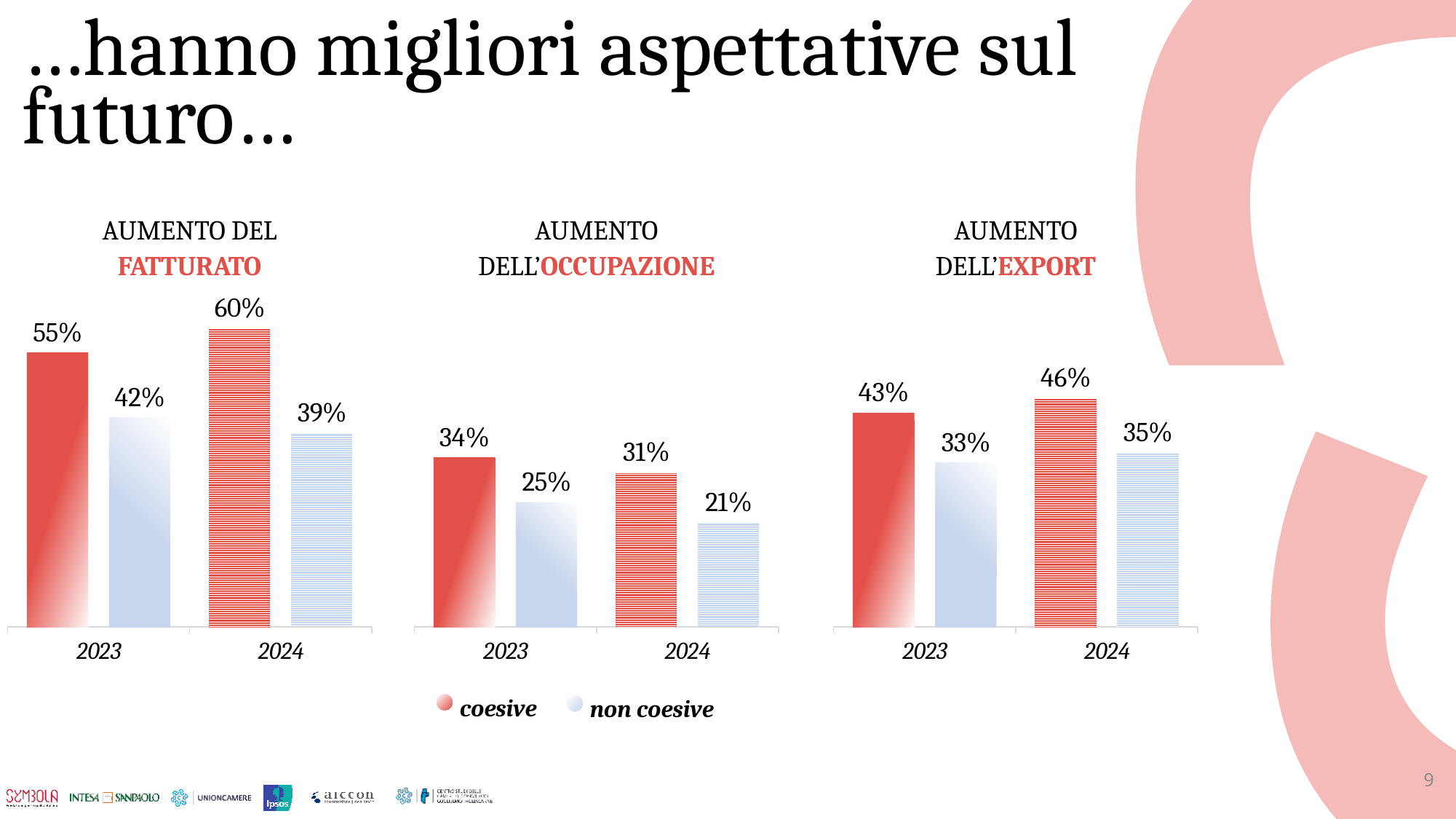
In the 'AUMENTO DELL'EXPORT' chart, what is the value for coesive in 2023? 43% In the 'AUMENTO DEL FATTURATO' chart, what is the difference between coesive and non coesive in 2024? 21% In the 'AUMENTO DEL FATTURATO' chart, what is the value for coesive in 2024? 60% In the 'AUMENTO DELL'OCCUPAZIONE' chart, which is larger: coesive in 2024 or non coesive in 2023? coesive in 2024 In the 'AUMENTO DELL'OCCUPAZIONE' chart, what is the value for non coesive in 2023? 25% In the 'AUMENTO DEL FATTURATO' chart, which bar has the highest value? coesive 2024 In the 'AUMENTO DELL'EXPORT' chart, what is the difference between coesive and non coesive in 2023? 10% What kind of chart is the 'AUMENTO DELL'OCCUPAZIONE' chart? bar chart In the 'AUMENTO DELL'EXPORT' chart, what is the value for non coesive in 2024? 35% How many series does the legend list? 2 In the 'AUMENTO DELL'OCCUPAZIONE' chart, which bar has the lowest value? non coesive 2024 In the 'AUMENTO DELL'OCCUPAZIONE' chart, does the non coesive value rise or fall from 2023 to 2024? fall